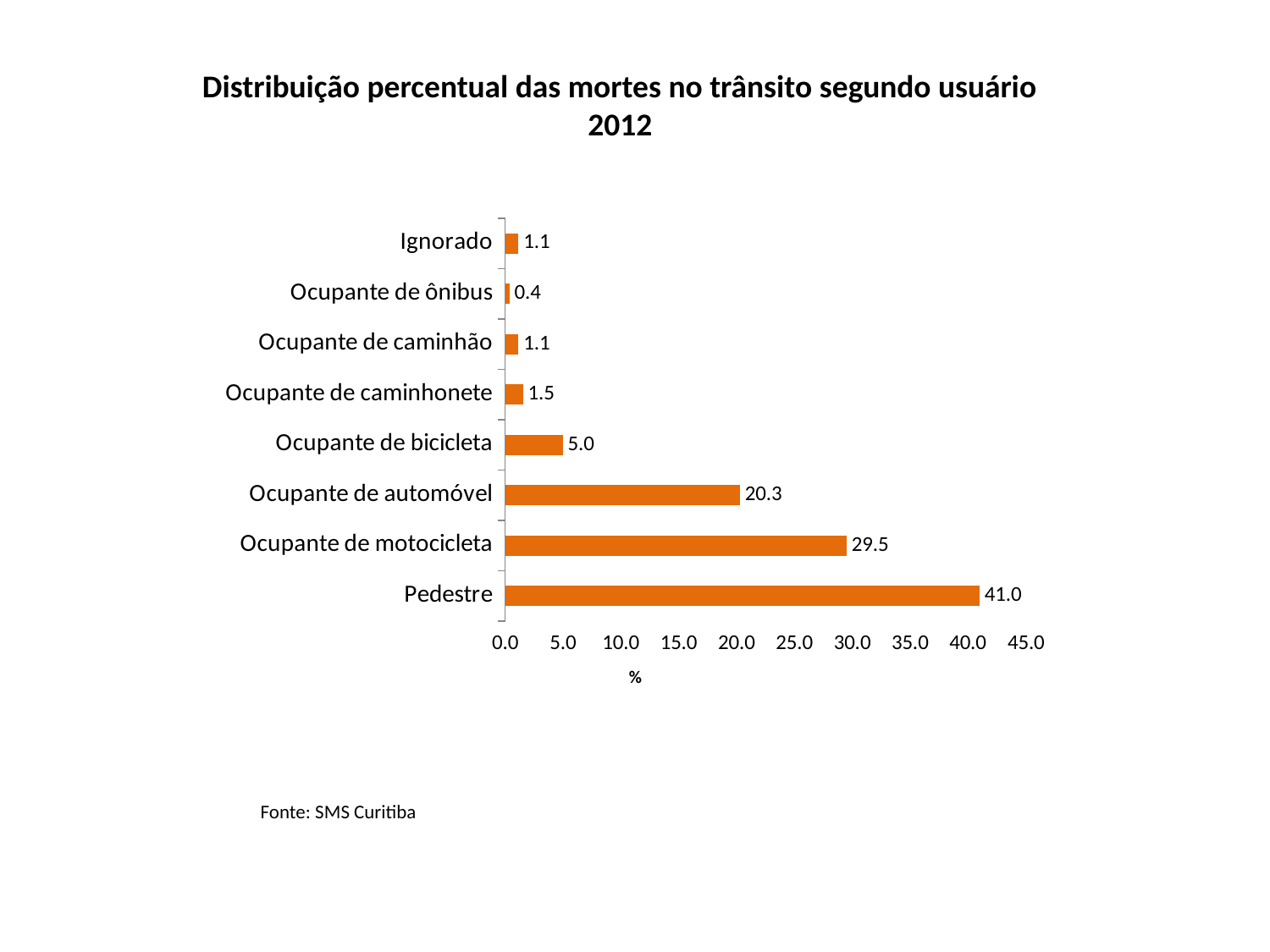
What is the difference between the values for Pedestre and Ocupante de motocicleta? 11.5 Is the value for Ocupante de automóvel greater or less than 25.0? less What is the value for Ocupante de ônibus? 0.4 How many categories are shown in the chart? 8 What is the value for Ocupante de bicicleta? 5.0 What is the value for Ocupante de motocicleta? 29.5 What kind of chart is shown on the slide? bar chart What is the value for Pedestre? 41.0 Which category has the highest value? Pedestre What is the difference between the values for Ocupante de automóvel and Ocupante de bicicleta? 15.3 Which category has the lowest value? Ocupante de ônibus Which is larger, the value for Ocupante de automóvel or the value for Ocupante de motocicleta? Ocupante de motocicleta